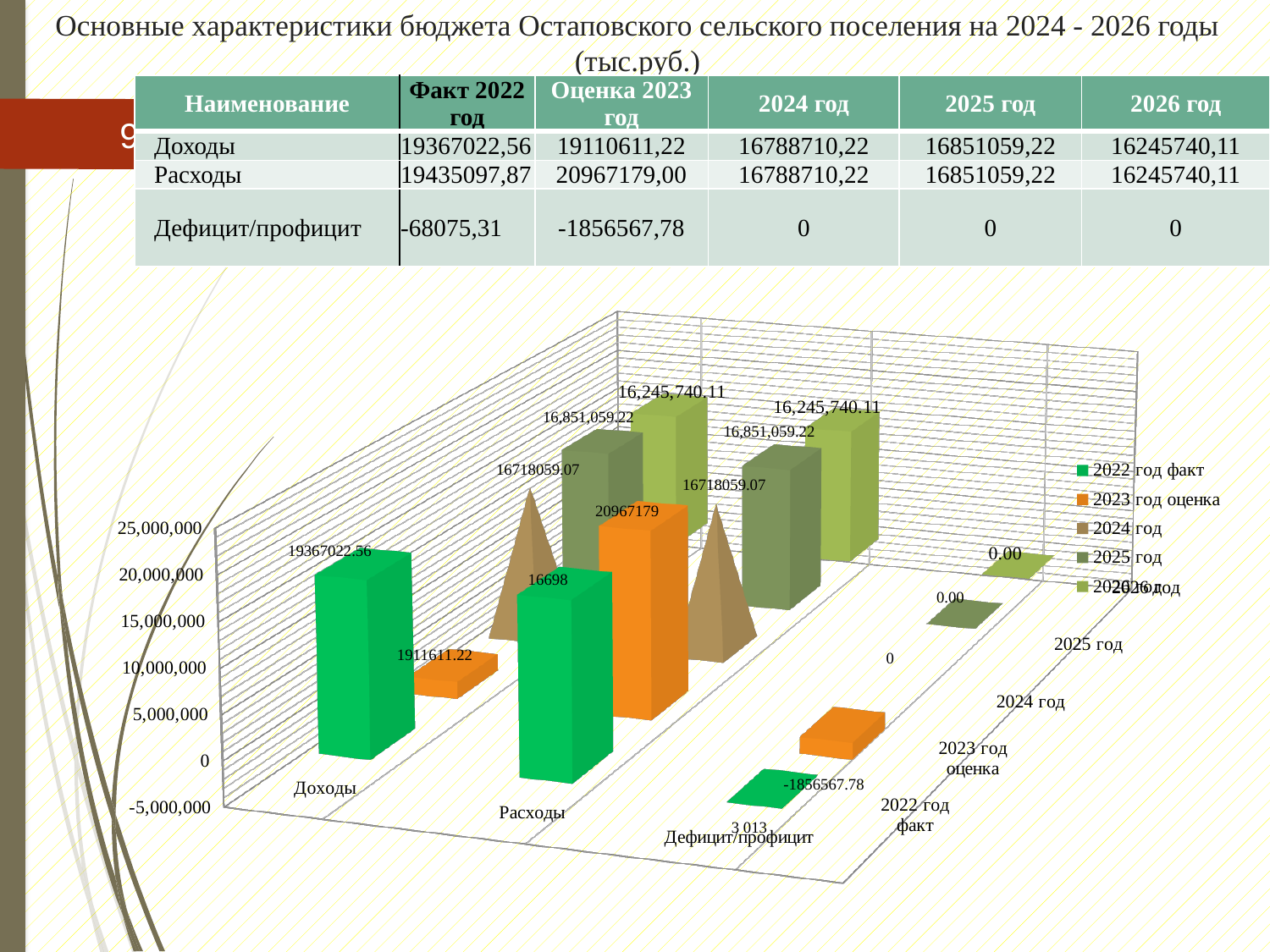
Which is larger in the chart: Доходы for 2022 год факт or Доходы for 2026 год? Доходы for 2022 год факт What kind of chart is shown on the slide? 3D bar chart What is the value of Доходы for 2022 год факт in the chart? 19367022.56 How many categories are shown along the x axis of the chart? 3 What is the value of Дефицит/профицит for 2023 год оценка in the chart? -1856567.78 What is the value of Доходы for 2026 год in the chart? 16,245,740.11 Which series has the highest value for Расходы in the chart? 2023 год оценка Is the value of Доходы for 2022 год факт greater or less than 15,000,000? greater What is the value of Расходы for 2023 год оценка in the chart? 20967179 What is the value of Расходы for 2025 год in the chart? 16,851,059.22 How many series does the chart legend list? 5 Which colour represents the 2023 год оценка series in the chart? Orange